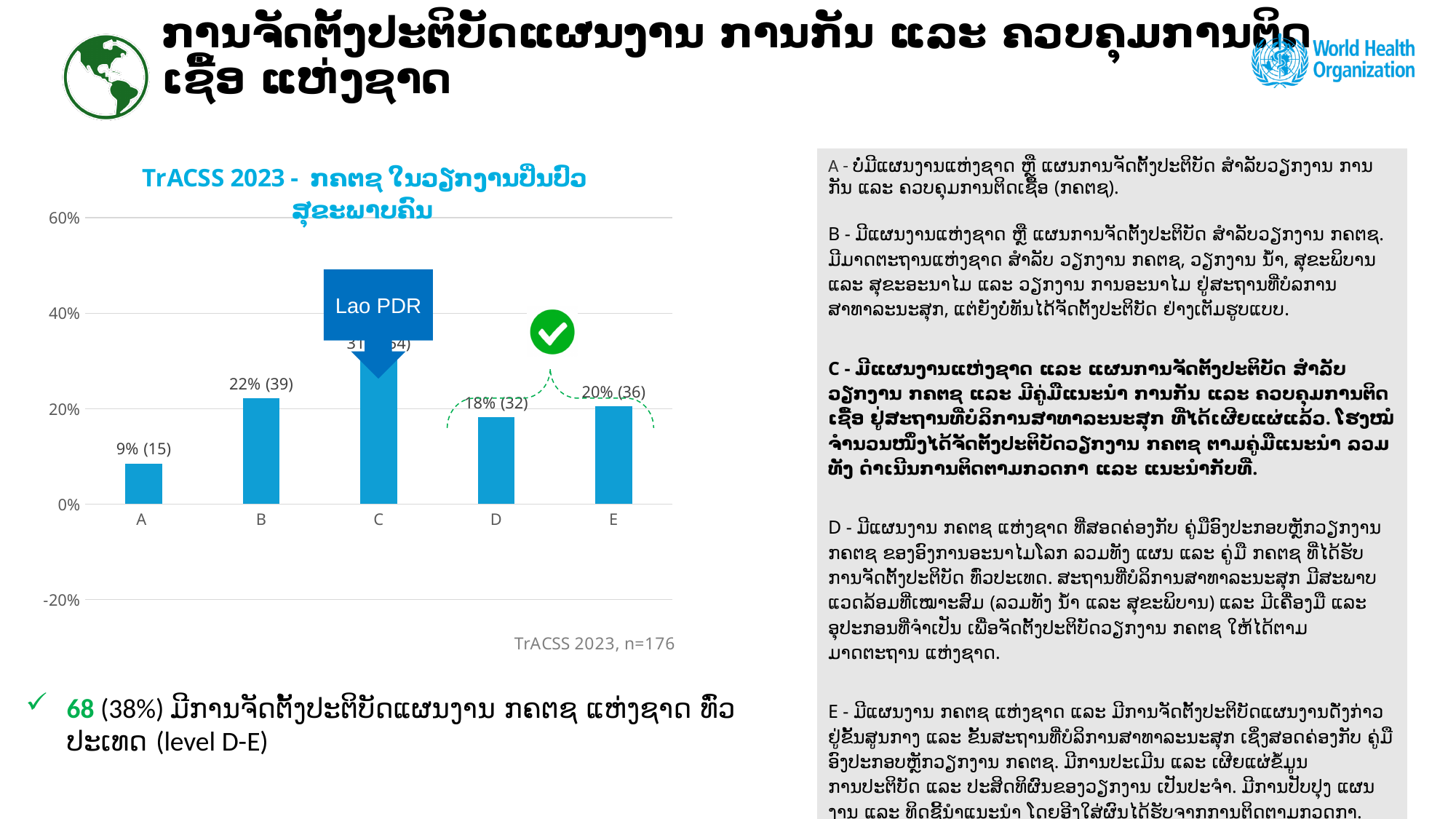
What is the value shown for category A? 9% (15) Is the value for category C greater or less than 20%? greater What is the value shown for category B? 22% (39) How many categories are shown on the x axis? 5 What is the difference in percentage between category B and category D? 4 percentage points What is the value shown for category D? 18% (32) What kind of chart is shown on the slide? bar chart Which category has the lowest bar? A What is the value shown for category E? 20% (36) Which category is marked with the 'Lao PDR' callout? C Which is larger, the value for D or the value for E? E Which category has the highest bar? C